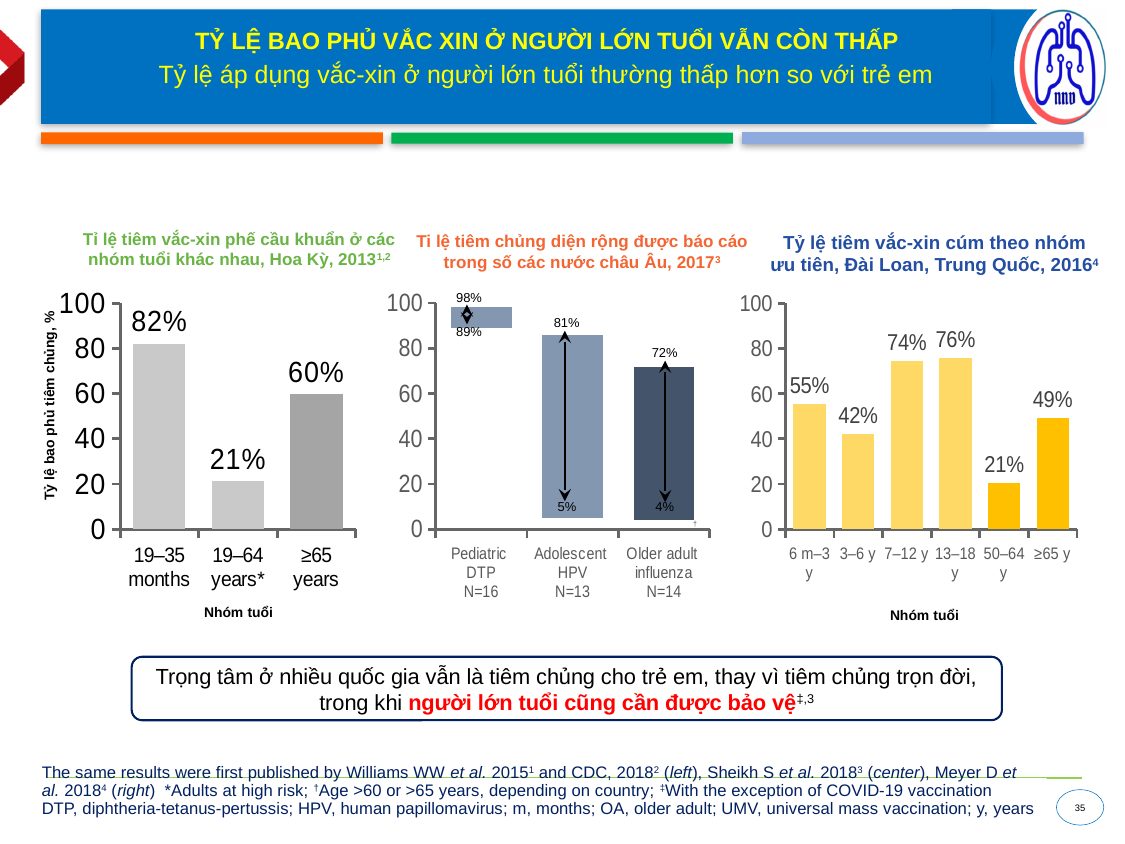
In the right chart, which is larger: the coverage for 3–6 y or for ≥65 y? ≥65 y In the center chart, what is the range of reported coverage for Pediatric DTP? 89% to 98% In the left chart, which age group has the lowest vaccination coverage? 19–64 years* In the left chart, what is the difference in coverage between the 19–35 months group and the ≥65 years group? 22% In the left chart, how many age groups are shown? 3 In the right chart, which age group has the lowest coverage? 50–64 y In the right chart, what is the influenza vaccination coverage for the 13–18 y group? 76% In the left chart, what is the pneumococcal vaccination coverage for the 19–35 months age group? 82% What type of chart is the left chart? Bar chart In the center chart, what is the lowest reported coverage for Older adult influenza? 4% In the right chart, how many age groups are shown? 6 In the center chart, what is the highest reported coverage for Adolescent HPV? 81%